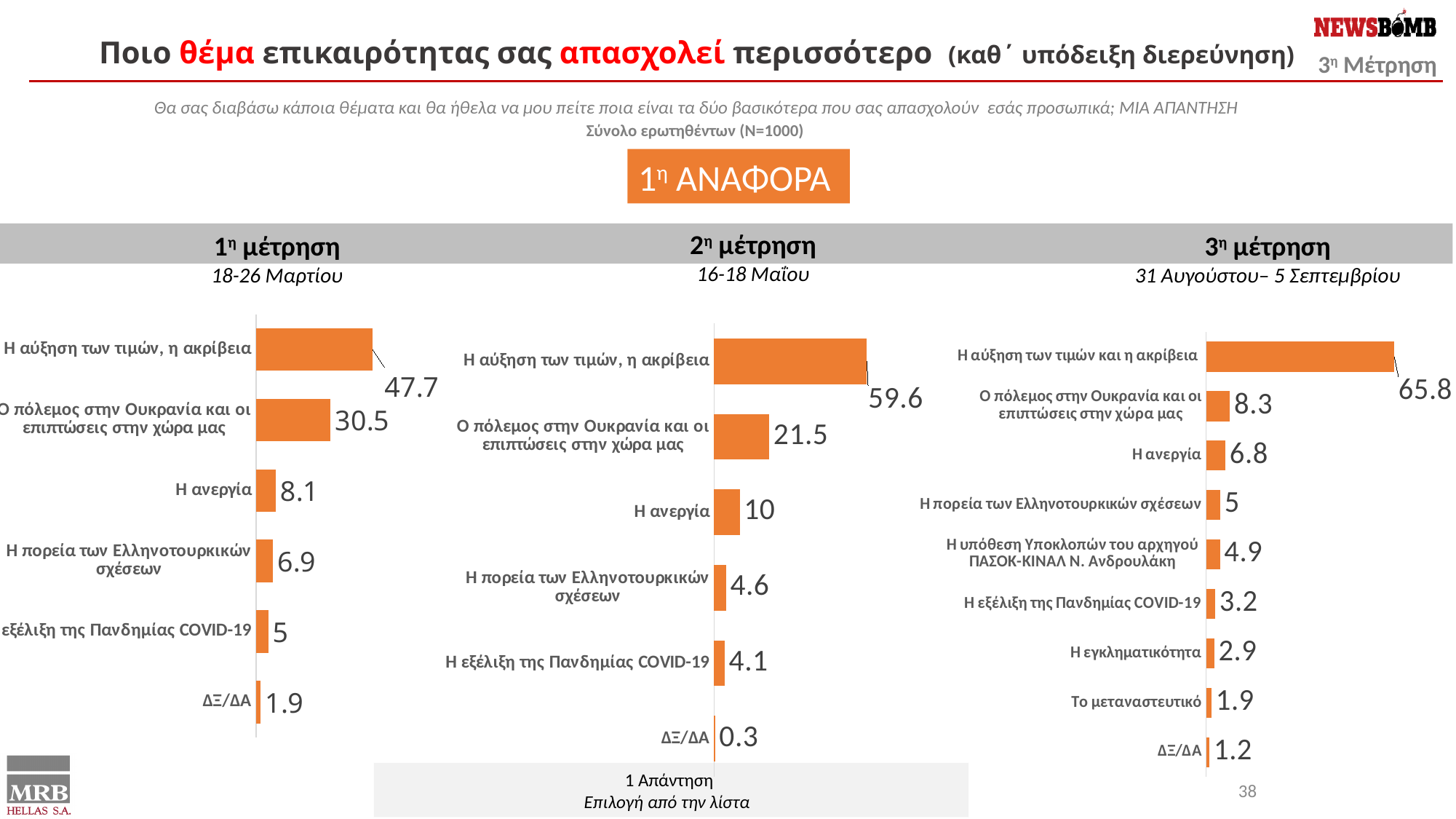
How many categories are shown in the 3η μέτρηση chart? 9 In the 2η μέτρηση chart, what is the difference between 'Η πορεία των Ελληνοτουρκικών σχέσεων' and 'Η εξέλιξη της Πανδημίας COVID-19'? 0.5 In the 2η μέτρηση chart, what is the value for 'Η ανεργία'? 10 In the 3η μέτρηση chart, which is larger: 'Η ανεργία' or 'Ο πόλεμος στην Ουκρανία και οι επιπτώσεις στην χώρα μας'? Ο πόλεμος στην Ουκρανία και οι επιπτώσεις στην χώρα μας In the 3η μέτρηση chart, which category has the highest value? Η αύξηση των τιμών και η ακρίβεια In the 1η μέτρηση chart, what is the difference between 'Η αύξηση των τιμών, η ακρίβεια' and 'Ο πόλεμος στην Ουκρανία και οι επιπτώσεις στην χώρα μας'? 17.2 In the 3η μέτρηση chart, what is the value for 'Η υπόθεση Υποκλοπών του αρχηγού ΠΑΣΟΚ-ΚΙΝΑΛ Ν. Ανδρουλάκη'? 4.9 In the 2η μέτρηση chart, which category has the lowest value? ΔΞ/ΔΑ How many categories are shown in the 1η μέτρηση chart? 6 In the 1η μέτρηση chart, what is the value for 'Η αύξηση των τιμών, η ακρίβεια'? 47.7 What type of chart is the 2η μέτρηση chart? Bar chart What date range is shown under the 3η μέτρηση chart? 31 Αυγούστου– 5 Σεπτεμβρίου